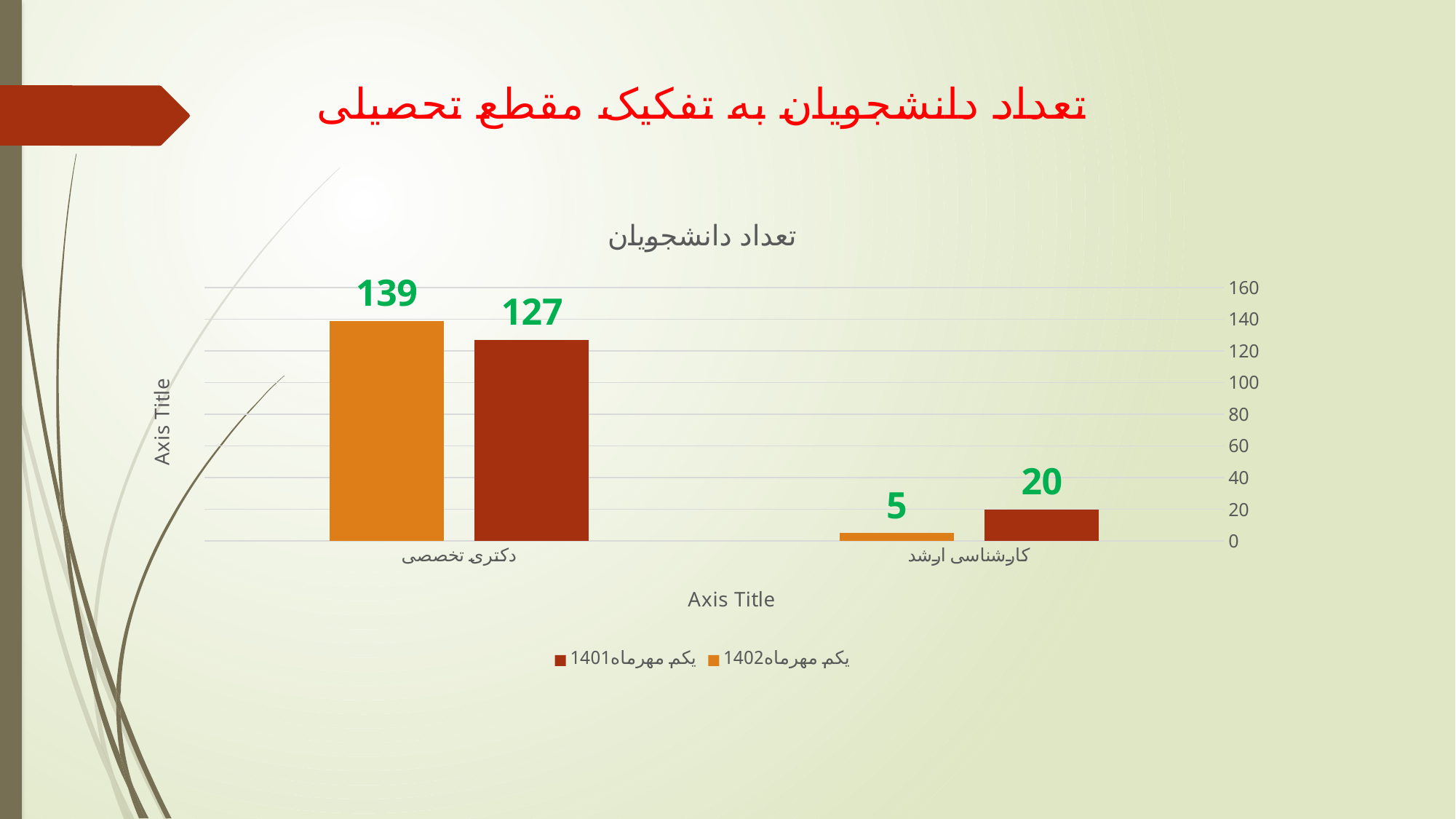
What is the value for دکتری تخصصی in the یکم مهرماه1401 series? 127 What is the difference between the یکم مهرماه1402 and یکم مهرماه1401 values for دکتری تخصصی? 12 What is the difference between the یکم مهرماه1401 and یکم مهرماه1402 values for کارشناسی ارشد? 15 Which category has the highest value in the یکم مهرماه1402 series? دکتری تخصصی What is the value for کارشناسی ارشد in the یکم مهرماه1401 series? 20 For کارشناسی ارشد, which series has the larger value, یکم مهرماه1402 or یکم مهرماه1401? یکم مهرماه1401 What is the value for کارشناسی ارشد in the یکم مهرماه1402 series? 5 What is the value for دکتری تخصصی in the یکم مهرماه1402 series? 139 How many categories are shown on the x axis? 2 How many series does the legend list? 2 What kind of chart is shown on the slide? Bar chart Which category has the lowest value in the یکم مهرماه1401 series? کارشناسی ارشد